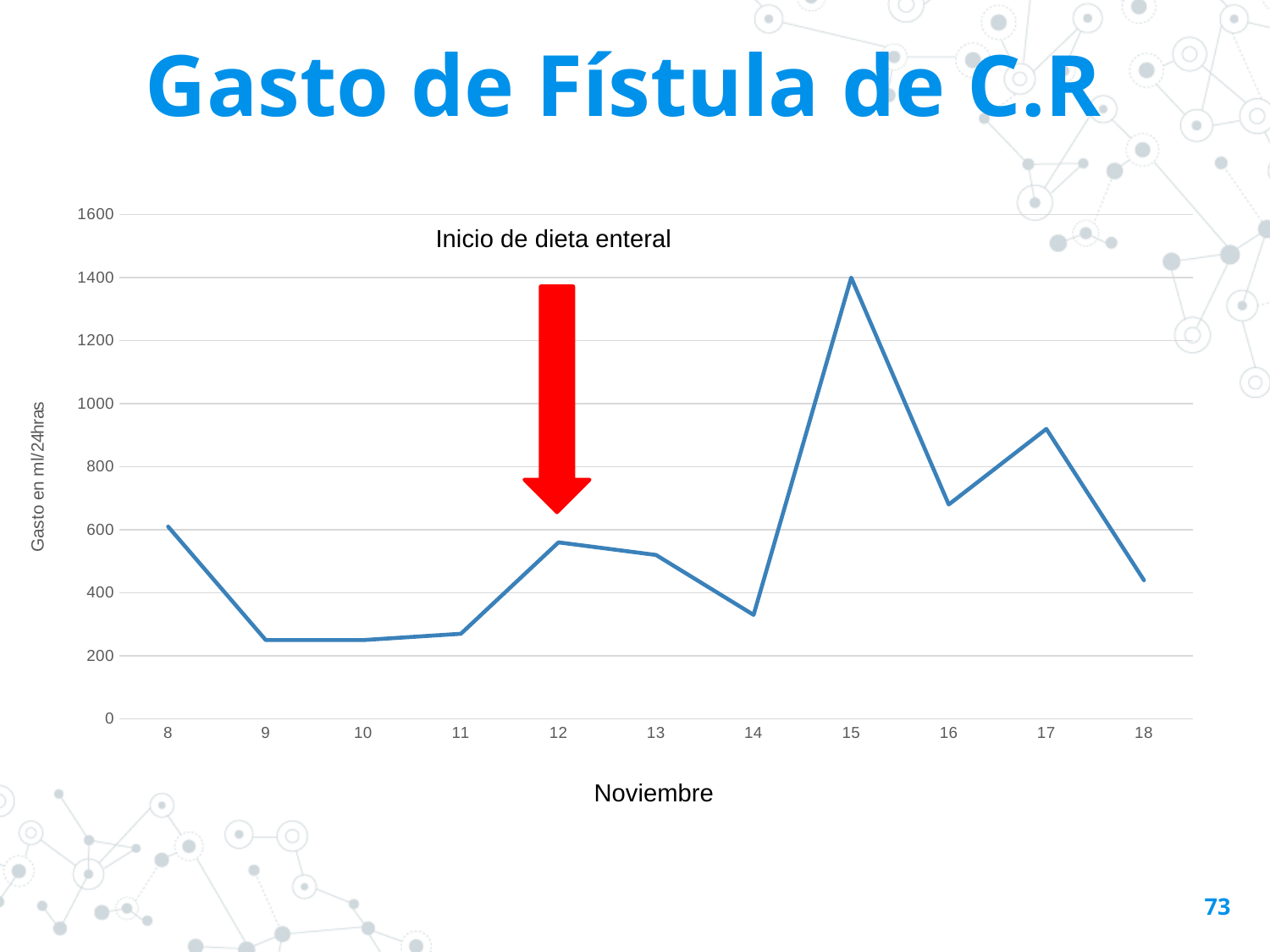
Is the value for day 8 greater or less than 400? greater What is the value plotted for day 15? 1400 How many data points are plotted on the chart? 11 On which day of Noviembre is the fistula output highest? 15 Do the values rise or fall from day 15 to day 16? fall What is the label on the vertical axis? Gasto en ml/24hras Is the value for day 16 greater or less than 600? greater What event does the red arrow annotation mark on the chart? Inicio de dieta enteral Which day has the larger value, day 14 or day 17? 17 Is the value for day 9 greater or less than 400? less What kind of chart is shown on the slide? line chart